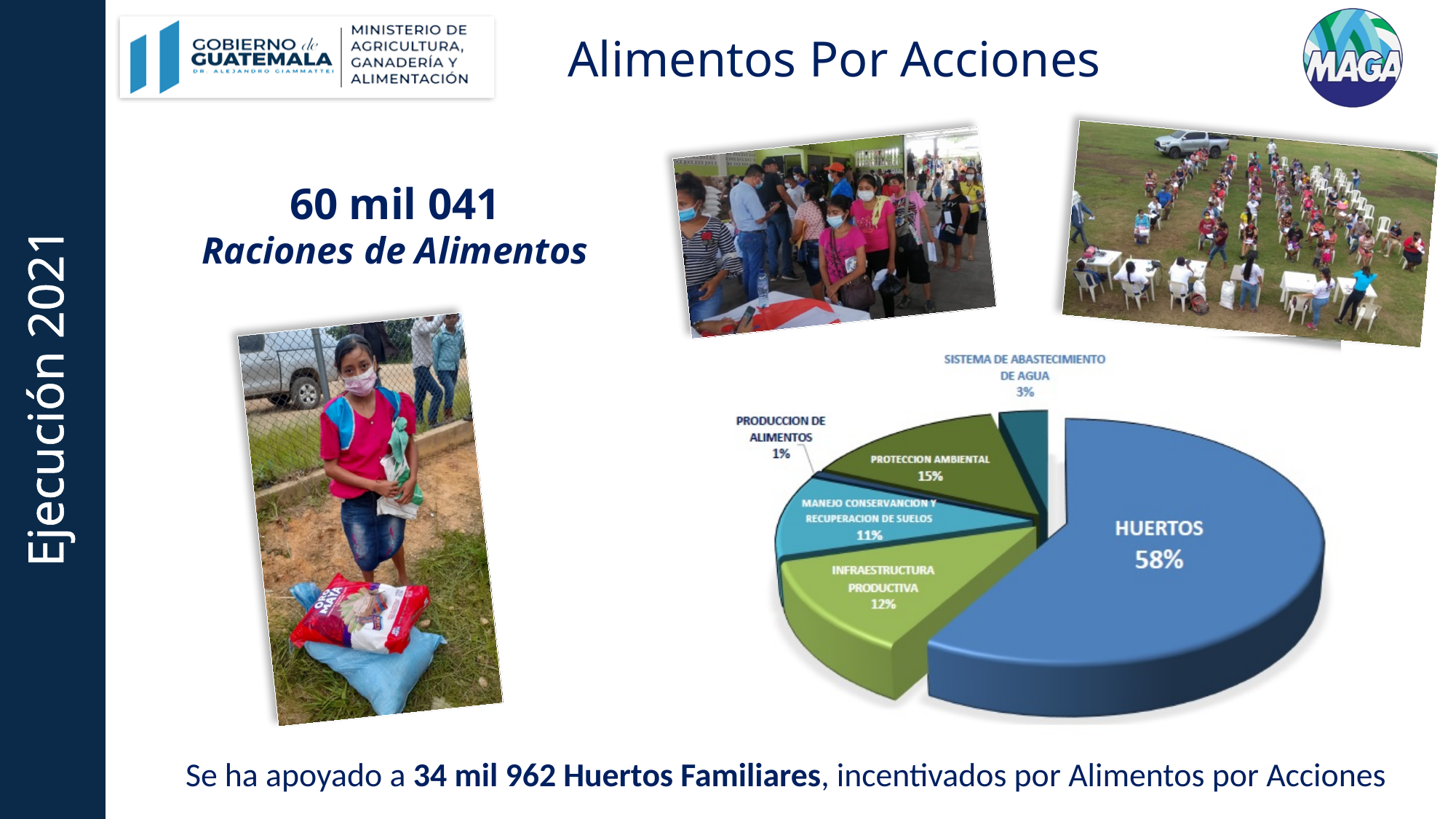
Which category has the largest slice of the pie? HUERTOS What percentage is shown for INFRAESTRUCTURA PRODUCTIVA? 12% Which is larger, INFRAESTRUCTURA PRODUCTIVA or SISTEMA DE ABASTECIMIENTO DE AGUA? INFRAESTRUCTURA PRODUCTIVA What is the difference in percentage points between HUERTOS and PROTECCION AMBIENTAL? 43 What percentage is shown for MANEJO CONSERVANCION Y RECUPERACION DE SUELOS? 11% Which category has the smallest slice of the pie? PRODUCCION DE ALIMENTOS What colour is the HUERTOS slice? blue How many slices does the pie chart have? 6 What share of the pie does HUERTOS represent? 58% What kind of chart is shown on the slide? pie chart What percentage is shown for PROTECCION AMBIENTAL? 15% What percentage is shown for SISTEMA DE ABASTECIMIENTO DE AGUA? 3%